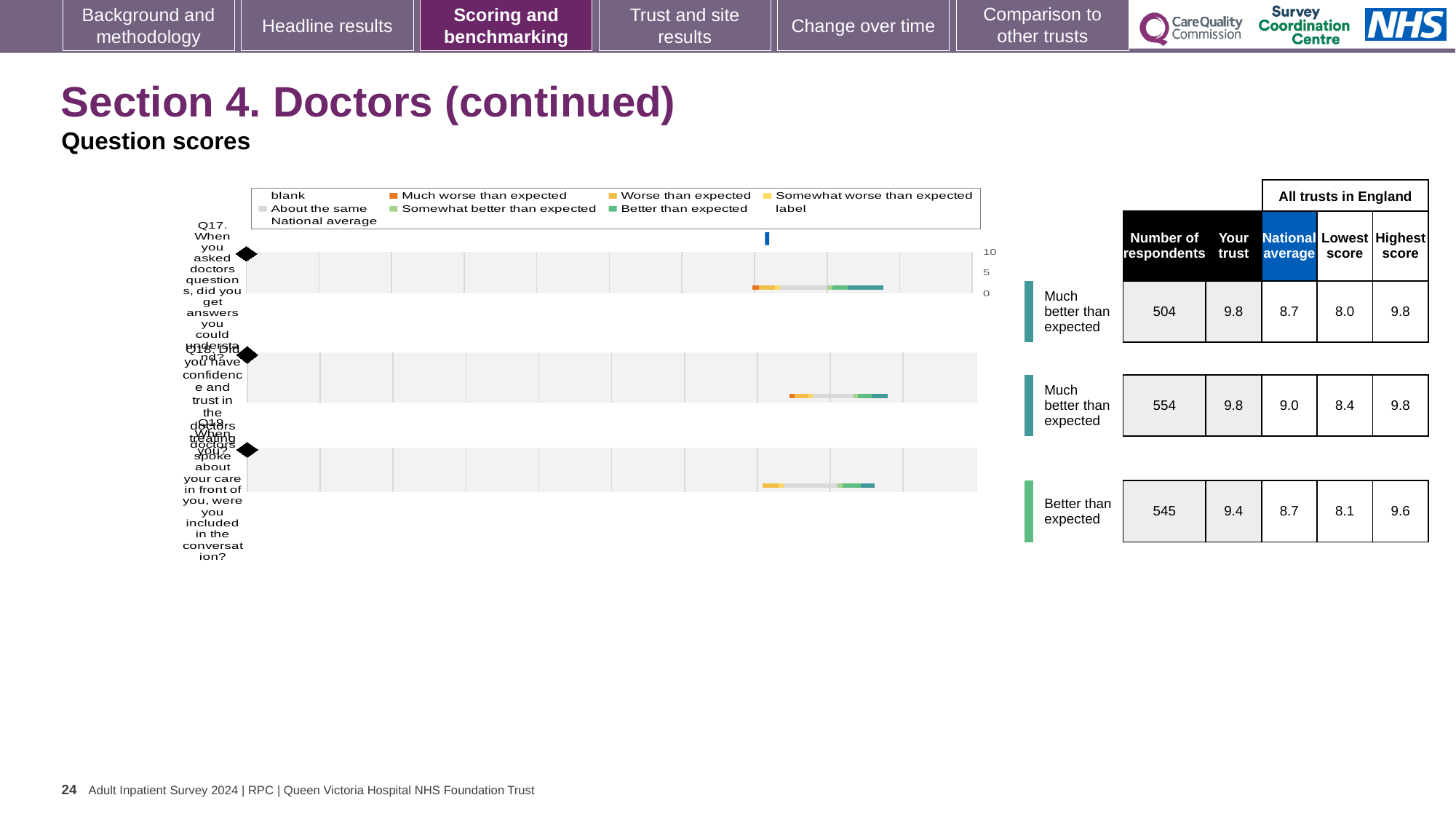
In the table beside the chart, what is the national average for Q18? 9.0 In the chart legend, what colour represents 'Much worse than expected'? orange In the table beside the chart, is the national average higher for Q17 or Q18? Q18 In the table beside the chart, which question has the lowest 'Your trust' score? Q19 In the table beside the chart, what is the lowest score across all trusts in England for Q19? 8.1 In the table beside the chart, what is the 'Your trust' score for Q19? 9.4 What benchmark category is shown next to the chart for Q19? Better than expected What kind of chart is shown on the slide? bar chart In the chart legend, what colour represents 'Better than expected'? teal How many survey questions (bars) are plotted in the chart? 3 In the table beside the chart, what is the difference between the 'Your trust' score and the national average for Q19? 0.7 In the table beside the chart, what is the number of respondents for Q17? 504